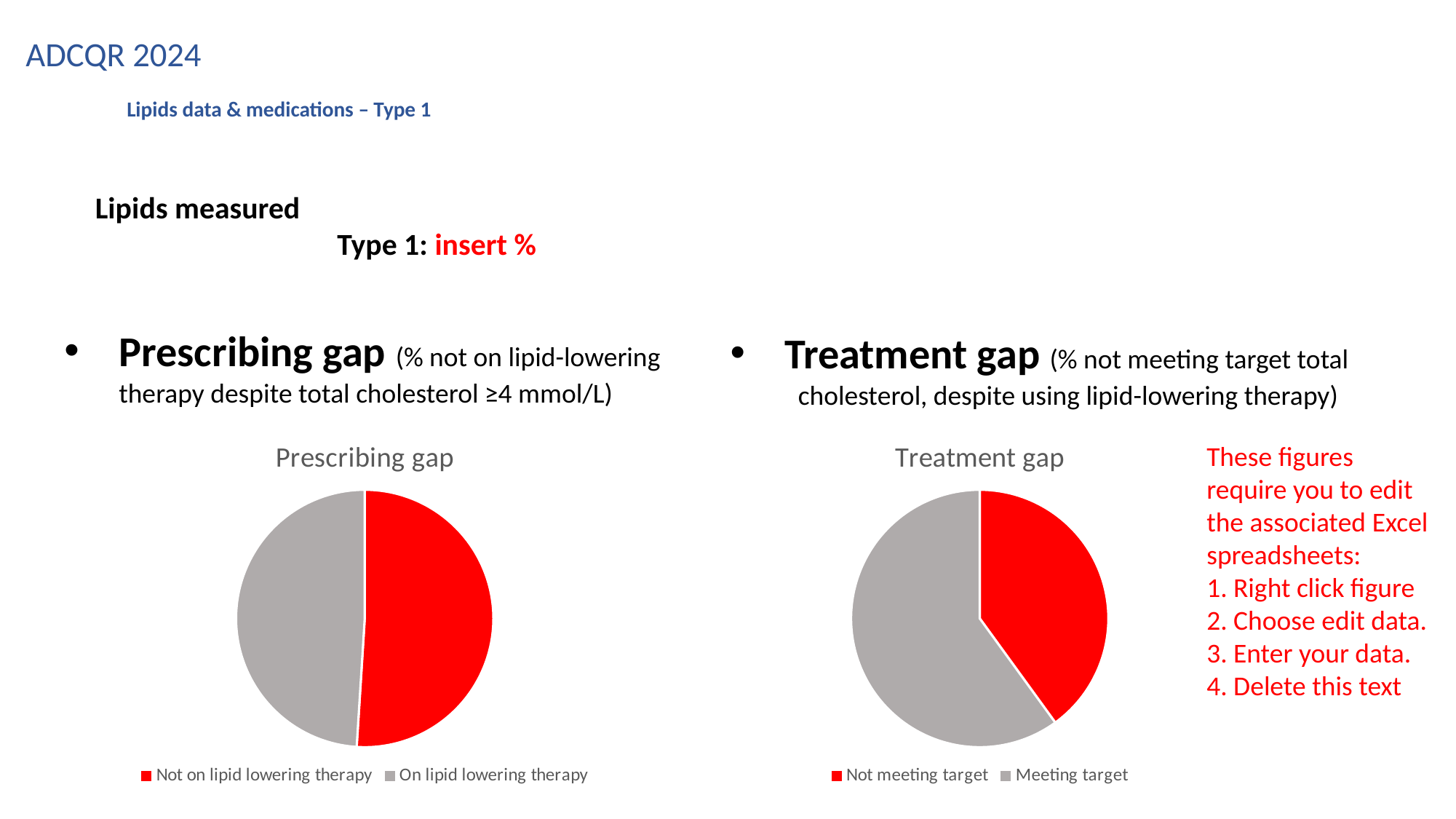
What kind of chart is the "Prescribing gap" chart? pie chart How many slices does the "Treatment gap" pie chart have? 2 In the "Treatment gap" pie chart, which slice is the smallest? Not meeting target In the "Treatment gap" pie chart, which is larger: "Not meeting target" or "Meeting target"? Meeting target How many entries does the legend of the "Treatment gap" chart list? 2 How many slices does the "Prescribing gap" pie chart have? 2 How many entries does the legend of the "Prescribing gap" chart list? 2 In the "Treatment gap" pie chart, which slice is the largest? Meeting target What are the two legend entries of the "Prescribing gap" chart? Not on lipid lowering therapy; On lipid lowering therapy What kind of chart is the "Treatment gap" chart? pie chart How many pie charts are shown on the slide? 2 In the "Treatment gap" chart, what colour is the "Not meeting target" slice? red